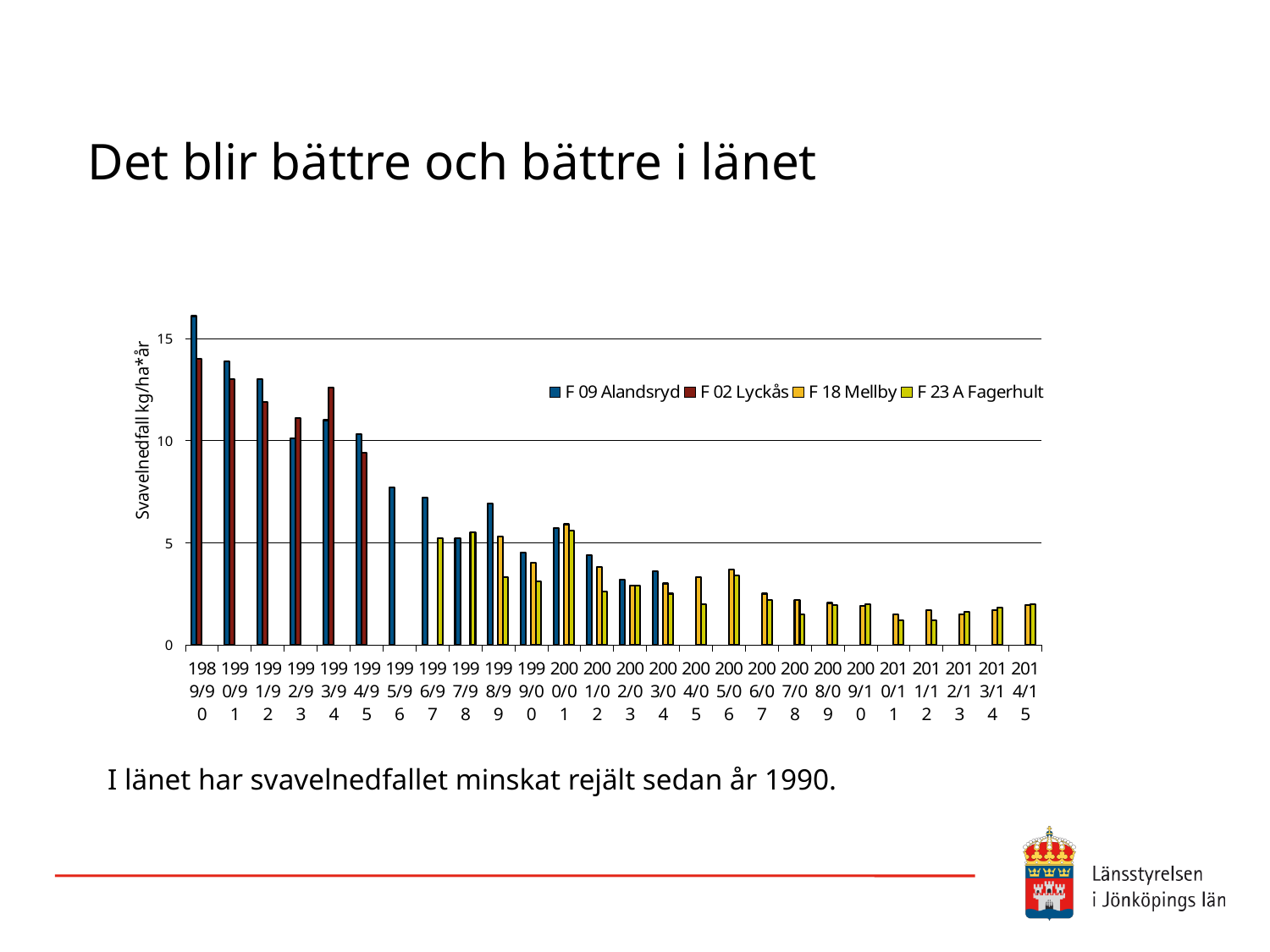
What is the label of the y axis of the chart? Svavelnedfall kg/ha*år How many series does the chart legend list? 4 What kind of chart is shown on the slide? bar chart In 1989/90, which is larger: the value for F 09 Alandsryd or the value for F 02 Lyckås? F 09 Alandsryd In which year does F 09 Alandsryd have its highest value? 1989/90 Is the value for F 02 Lyckås in 1993/94 greater or less than 10? greater Is the value for F 23 A Fagerhult in 2014/15 greater or less than 5? less Do the values for F 09 Alandsryd generally rise or fall from 1989/90 onwards? fall Is the value for F 09 Alandsryd in 1989/90 greater or less than 15? greater How many year categories are shown along the x axis of the chart? 26 Which series is listed first in the chart legend? F 09 Alandsryd